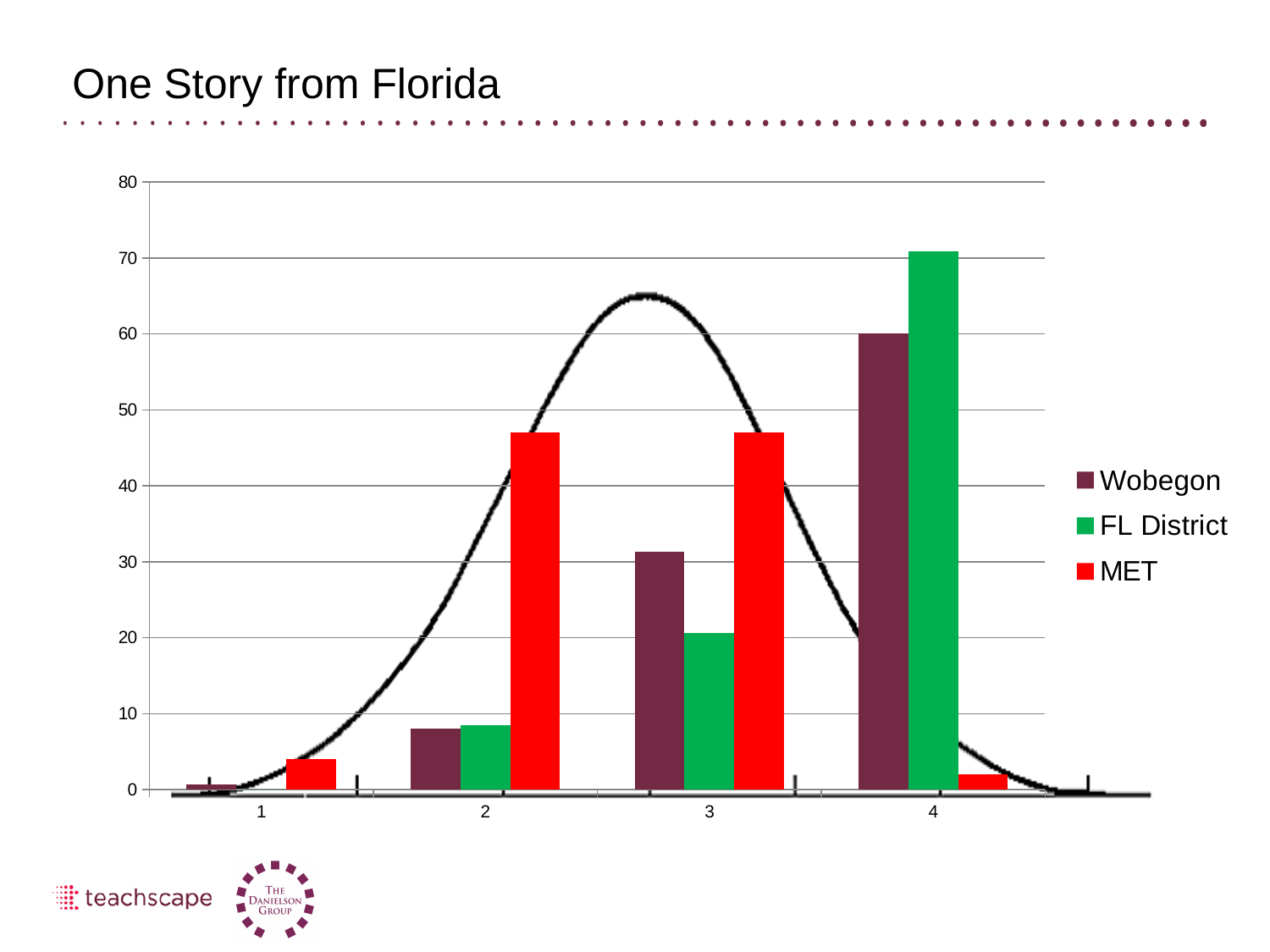
Is the MET value for category 2 greater or less than 40? greater Which category has the highest FL District value? 4 Which series is shown in red in the legend? MET Is the Wobegon value for category 3 greater or less than 30? greater How many series does the legend list? 3 What kind of chart is shown on the slide? bar chart Which is larger for category 4, the FL District value or the MET value? FL District Which category has the lowest Wobegon value? 1 Which is larger for category 3, the Wobegon value or the FL District value? Wobegon What is the title of the slide containing the chart? One Story from Florida How many categories are shown on the x axis? 4